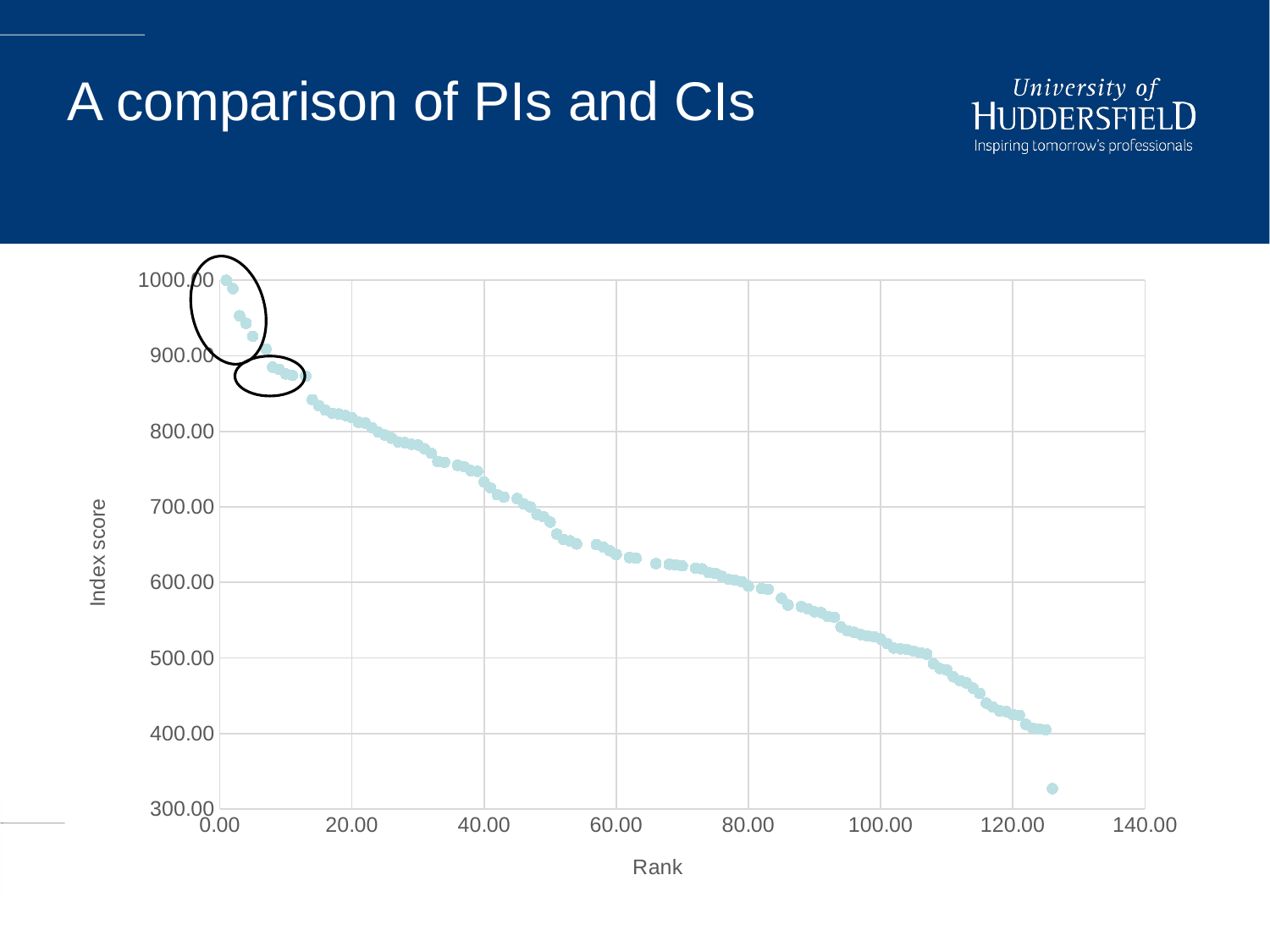
Is the index score of the highest point on the chart greater or less than 900? greater What kind of chart is shown on the slide? Scatter chart What is the label of the x axis of the chart? Rank Is the index score of the point at rank 100 greater or less than 500? greater Which has the higher index score: the point at rank 20 or the point at rank 120? The point at rank 20 Is the index score of the point at rank 20 greater or less than 800? greater What is the label of the y axis of the chart? Index score Does the index score rise or fall as rank increases along the x axis? Fall